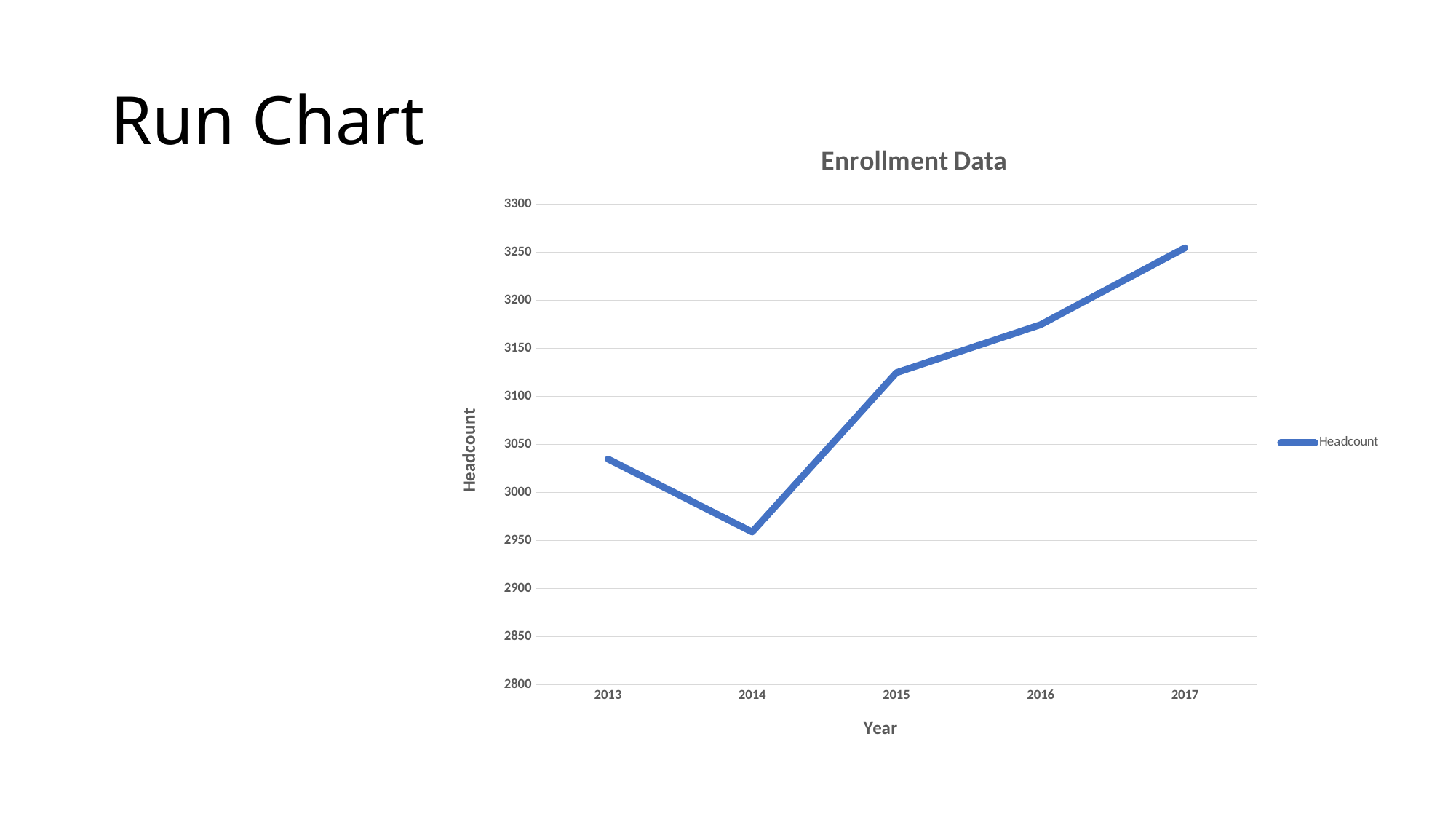
What is the title of the chart? Enrollment Data Which year has the larger headcount, 2013 or 2015? 2015 Which year has the lowest headcount? 2014 Is the headcount for 2017 greater or less than 3200? greater How many years are plotted on the x axis? 5 Is the headcount for 2014 greater or less than 3000? less Which year has the highest headcount? 2017 Does the headcount rise or fall from 2014 to 2017? rise Is the headcount for 2015 greater or less than 3100? greater How many series does the legend list? 1 What kind of chart is shown on the slide? line chart